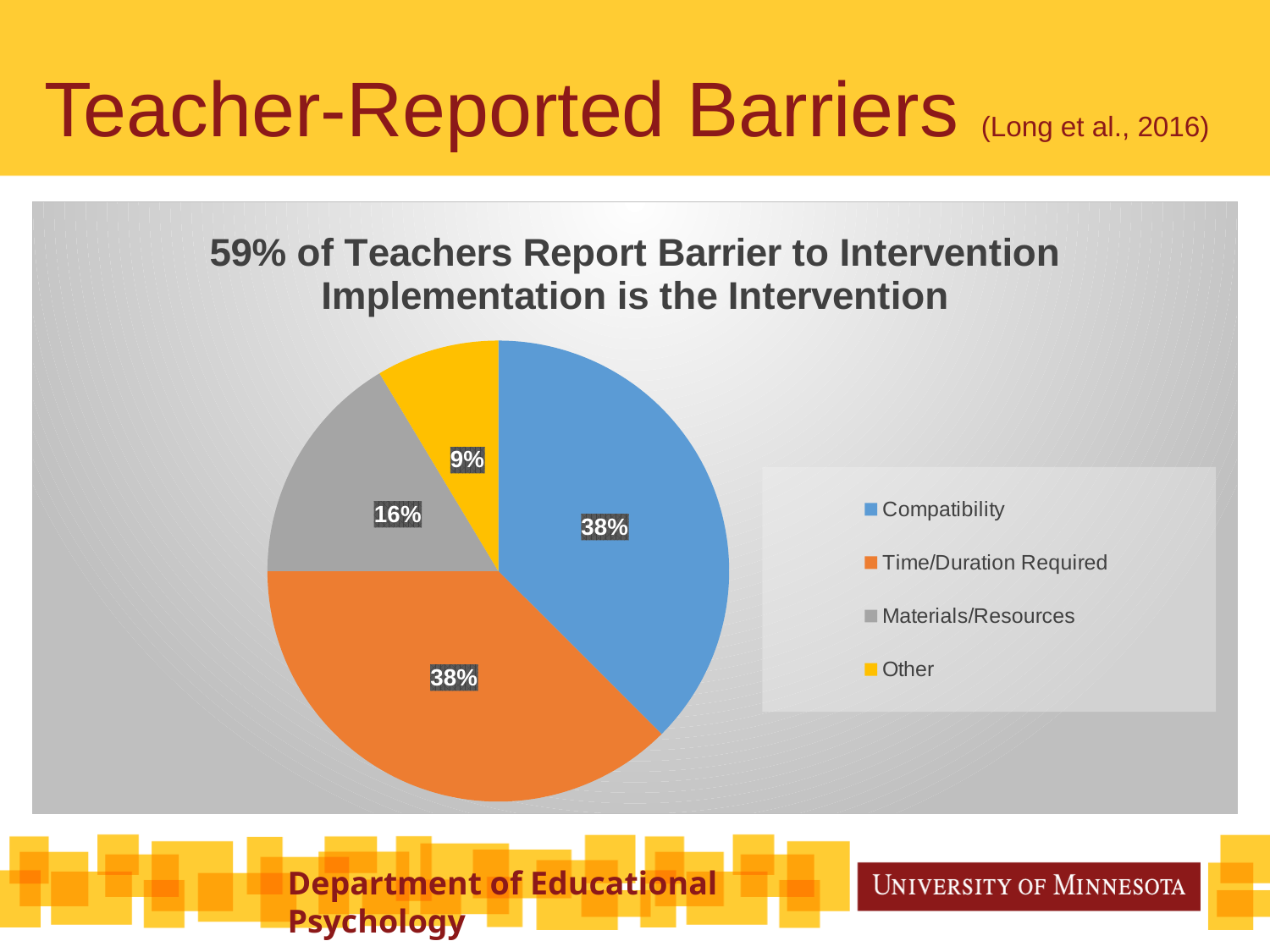
What percentage of the pie is labelled for Materials/Resources? 16% How many entries does the legend list? 4 What percentage of the pie is labelled for Time/Duration Required? 38% What kind of chart is shown on the slide? pie chart How many percentage points larger is the Materials/Resources slice than the Other slice? 7 What percentage of the pie is labelled for Compatibility? 38% What colour is the slice for Time/Duration Required? orange Which category has the smallest slice of the pie? Other How many categories are shown in the pie chart? 4 Which is larger, the slice for Materials/Resources or the slice for Other? Materials/Resources What percentage of the pie is labelled for Other? 9% How many percentage points larger is the Compatibility slice than the Materials/Resources slice? 22